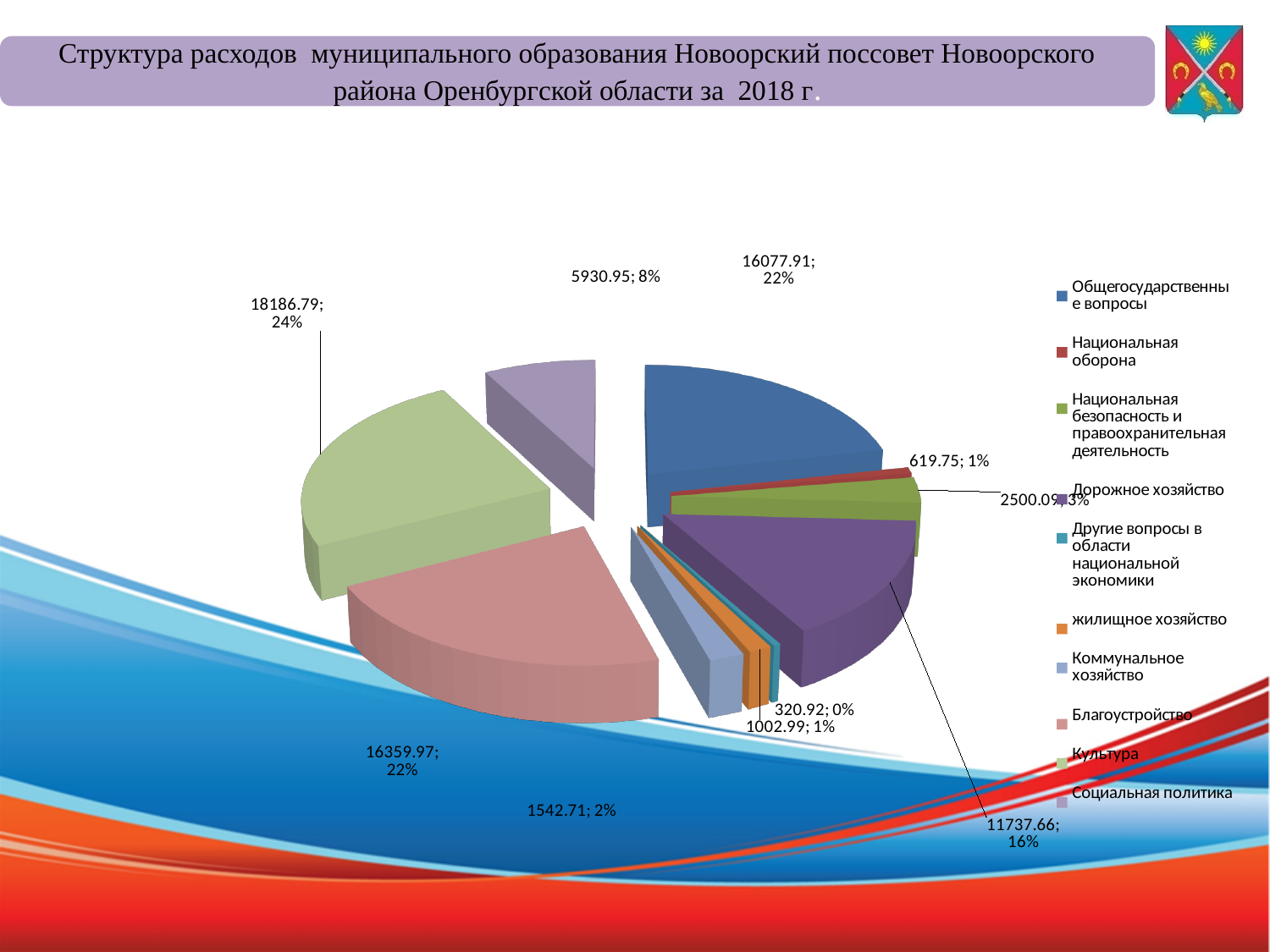
What share of the pie does the Культура slice represent? 24% What share of the pie does Социальная политика represent? 8% What year does the chart title say the expenditure structure is for? 2018 What is the difference between the value for Культура (18186.79) and the value for Дорожное хозяйство (11737.66)? 6449.13 What kind of chart is shown on the slide? pie chart Which is larger: the Культура slice or the Социальная политика slice? Культура Which category has the smallest slice of the pie? Другие вопросы в области национальной экономики What is the value shown for the Дорожное хозяйство slice? 11737.66 What share of the pie does Дорожное хозяйство represent? 16% Which category has the largest slice of the pie? Культура What is the value shown for the Культура slice? 18186.79 How many categories does the legend of the pie chart list? 10